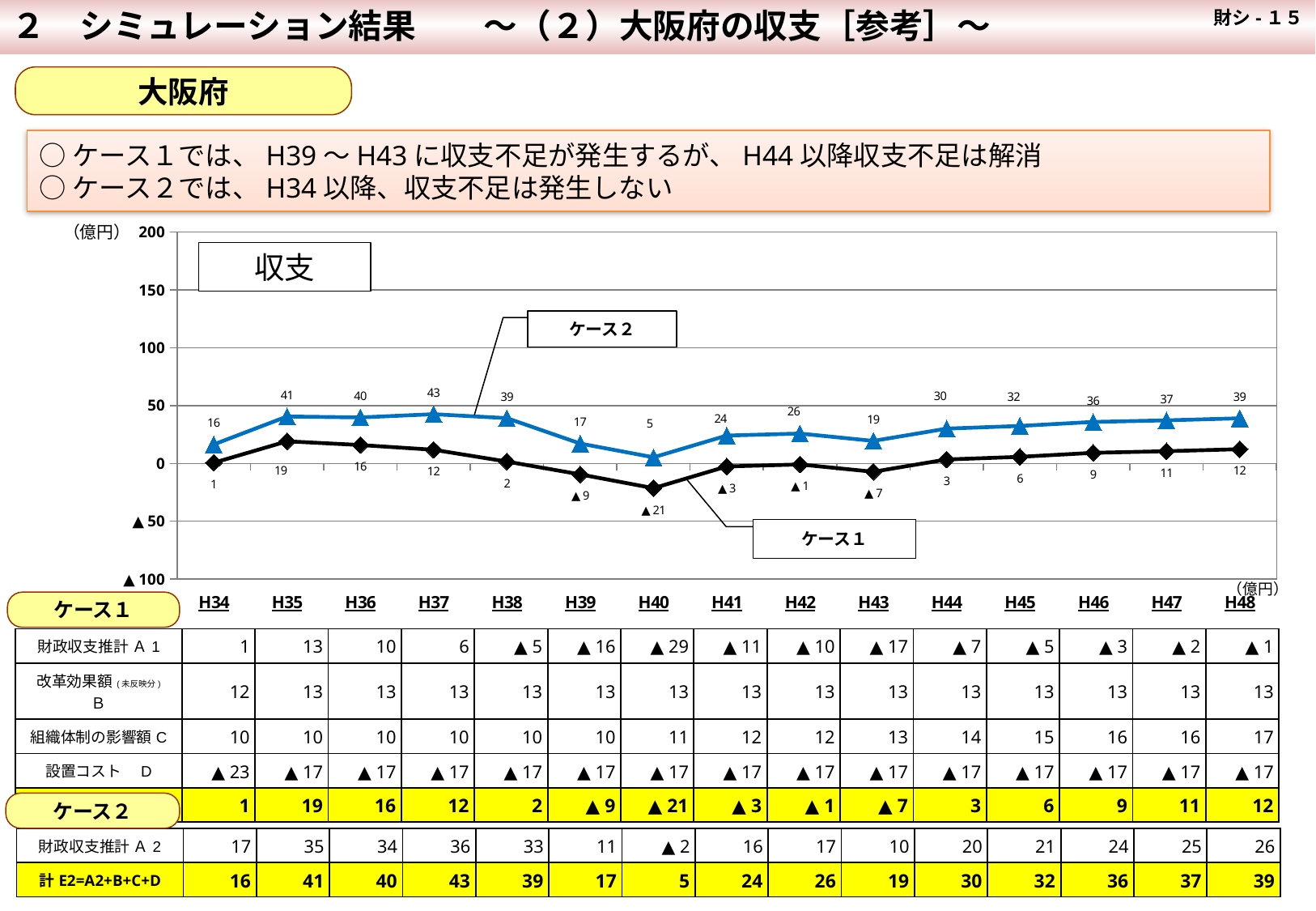
Do the values for ケース2 rise or fall from H44 to H48? rise At which year does ケース1 reach its lowest value? H40 What is the difference between ケース2 and ケース1 at H35? 22 Which series has the larger value at H43, ケース1 or ケース2? ケース2 What is the value for ケース1 at H40? ▲21 How many series are plotted in the chart? 2 What is the value for ケース2 at H37? 43 What kind of chart is shown on the slide? line chart What is the title shown in the box inside the chart? 収支 At which year does ケース2 reach its highest value? H37 What is the value for ケース2 at H40? 5 How many years are plotted along the x axis? 15